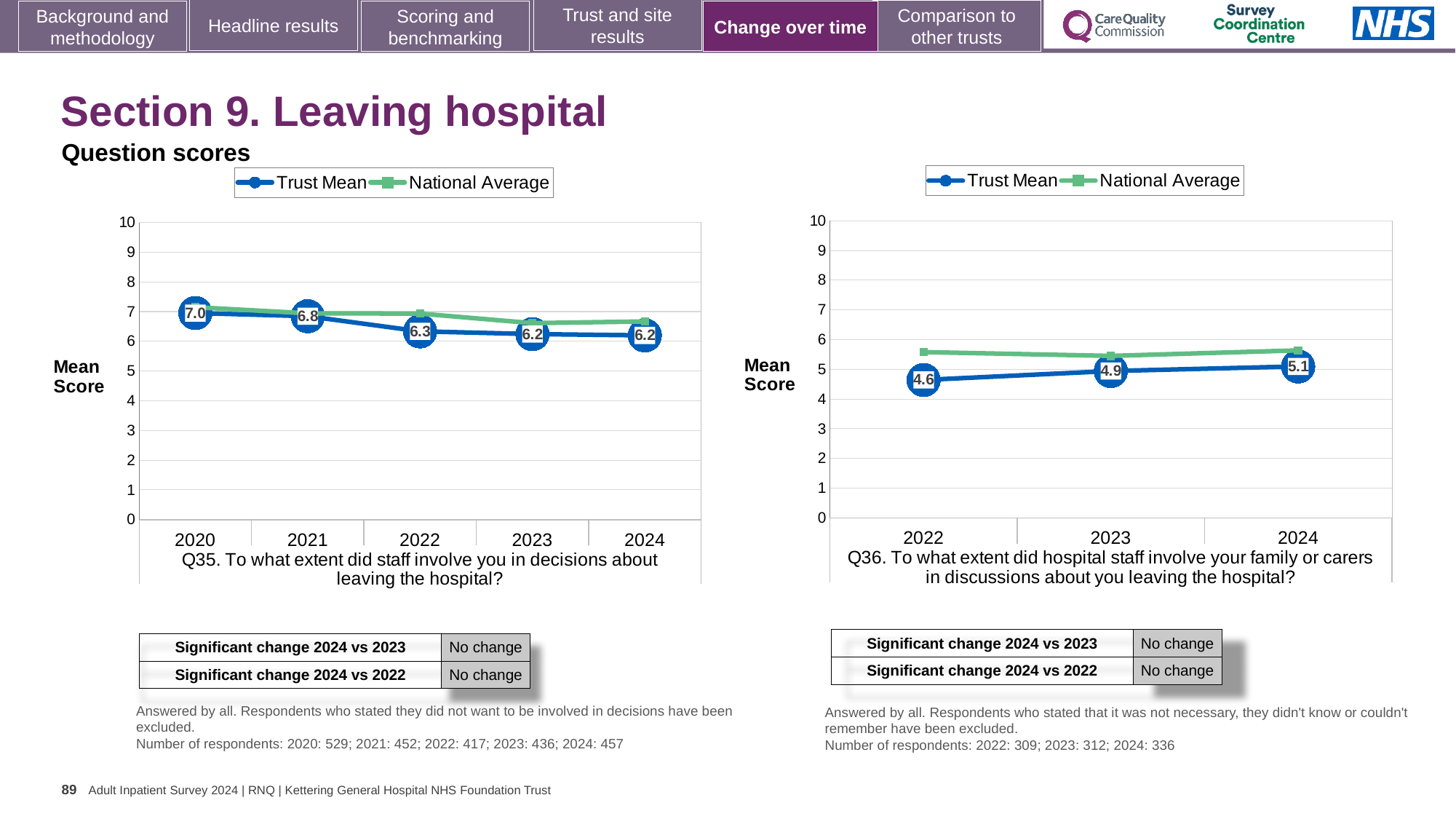
In the Q36 chart (right), which year has the lowest Trust Mean score? 2022 In the Q36 chart (right), what is the Trust Mean score for 2024? 5.1 In the Q35 chart (left), what is the Trust Mean score for 2022? 6.3 In the Q35 chart (left), what is the Trust Mean score for 2020? 7.0 In the Q36 chart (right), is the National Average for 2022 greater or less than 5? greater How many years are plotted on the x axis of the Q35 chart (left)? 5 In the Q36 chart (right), is the Trust Mean score higher in 2022 or in 2023? 2023 In the Q35 chart (left), what is the difference between the Trust Mean score in 2020 and in 2024? 0.8 What kind of chart is used for Q35 (left)? Line chart How many series does the legend of the Q36 chart (right) list? 2 In the Q35 chart (left), which year has the highest Trust Mean score? 2020 In the Q36 chart (right), what is the difference between the Trust Mean score in 2024 and in 2022? 0.5